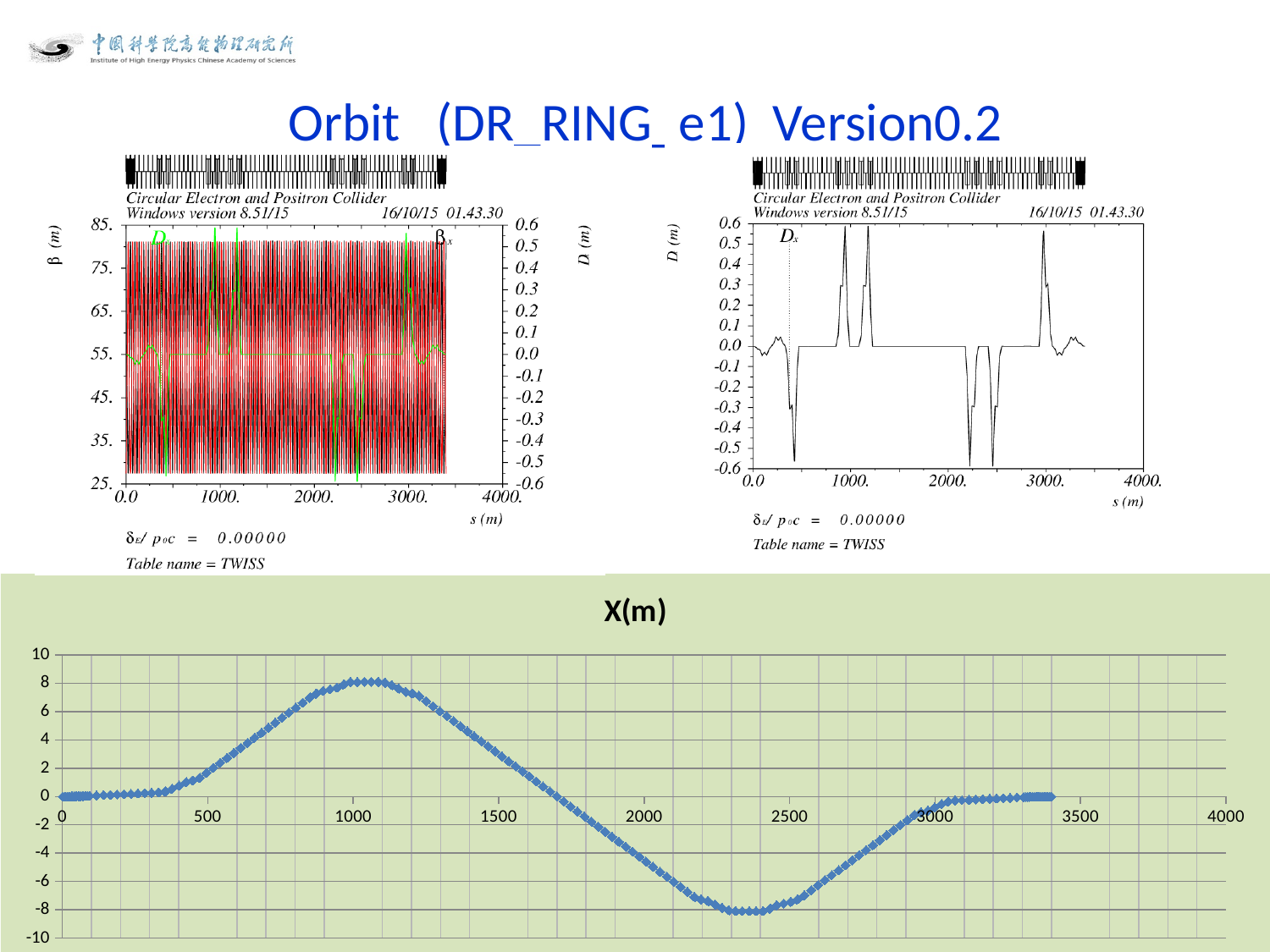
In the top-right chart, is the Dx value at its lowest point near s = 400 greater or less than -0.5? less In the top-left chart, which two quantities are labelled on the plot? Dx and βx In the bottom chart X(m), do the values rise or fall between s = 2500 and s = 3000? rise What kind of chart is the bottom chart titled X(m)? Line chart with markers (scatter) In the bottom chart X(m), is the value at s = 2000 greater or less than -2? less In the bottom chart X(m), is the value at s = 2300 greater or less than -6? less In the bottom chart X(m), is the peak value near s = 1000 larger than the value near s = 2300? Yes, the value near s = 1000 In the bottom chart X(m), do the values rise or fall between s = 1000 and s = 2000? fall What is the title of the bottom chart? X(m)